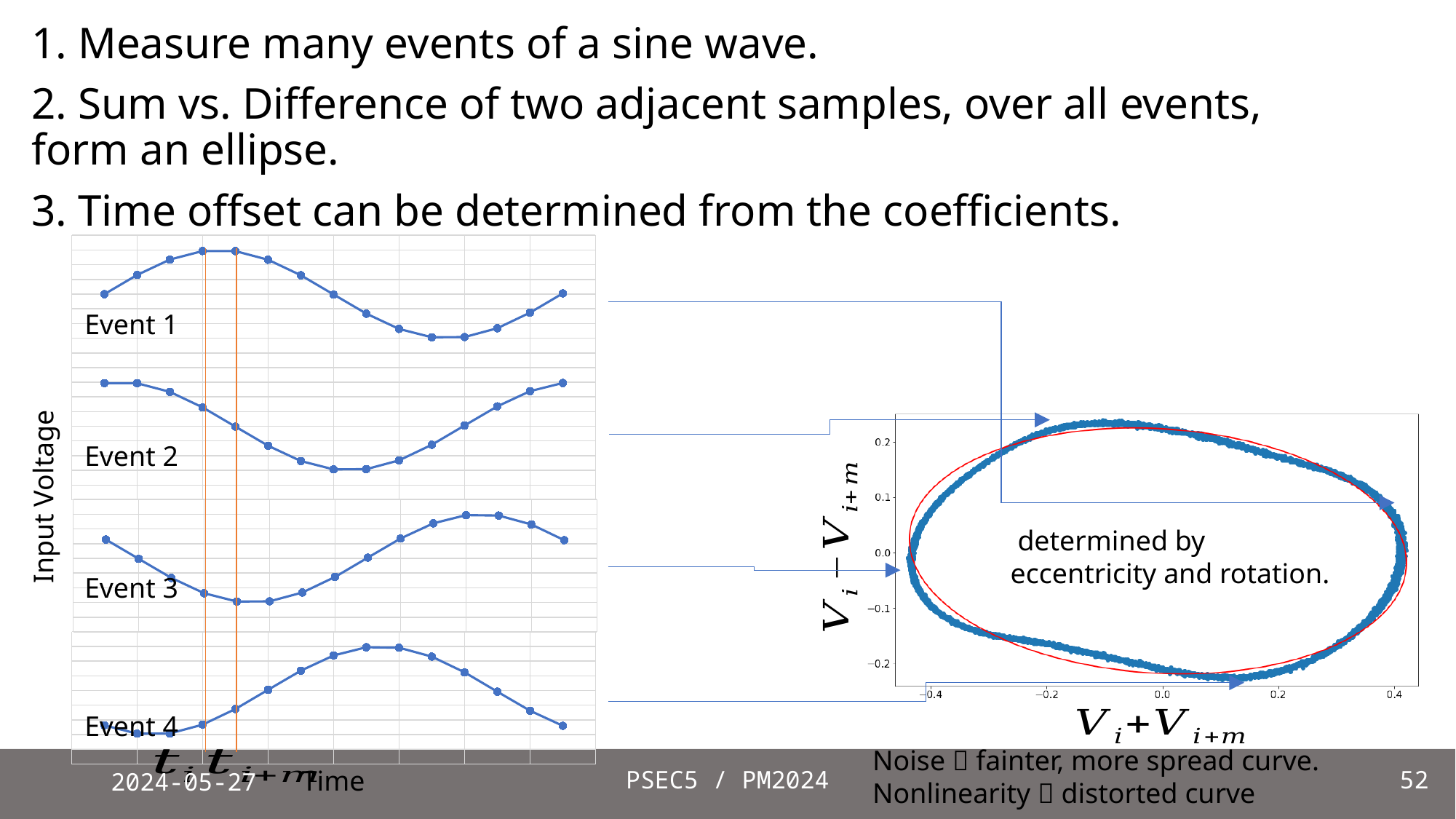
How many events are plotted on the left chart? 4 What is the y-axis label of the left chart? Input Voltage How many data points does the Event 1 curve on the left chart have? 15 What kind of chart is the right chart showing the ellipse? scatter plot On the right chart, is the highest y value reached by the ellipse greater or less than 0.1? greater On the right chart, is the lowest y value reached by the ellipse greater or less than -0.1? less What kind of chart is the left chart showing Event 1 to Event 4? line chart On the right chart, is the smallest x value reached by the ellipse greater or less than -0.2? less On the left chart, does the Event 2 curve rise or fall from its first point to its lowest point? fall What is the x-axis label of the right chart? V_i + V_i+m On the left chart, does the Event 4 curve rise or fall from its first point to its peak? rise